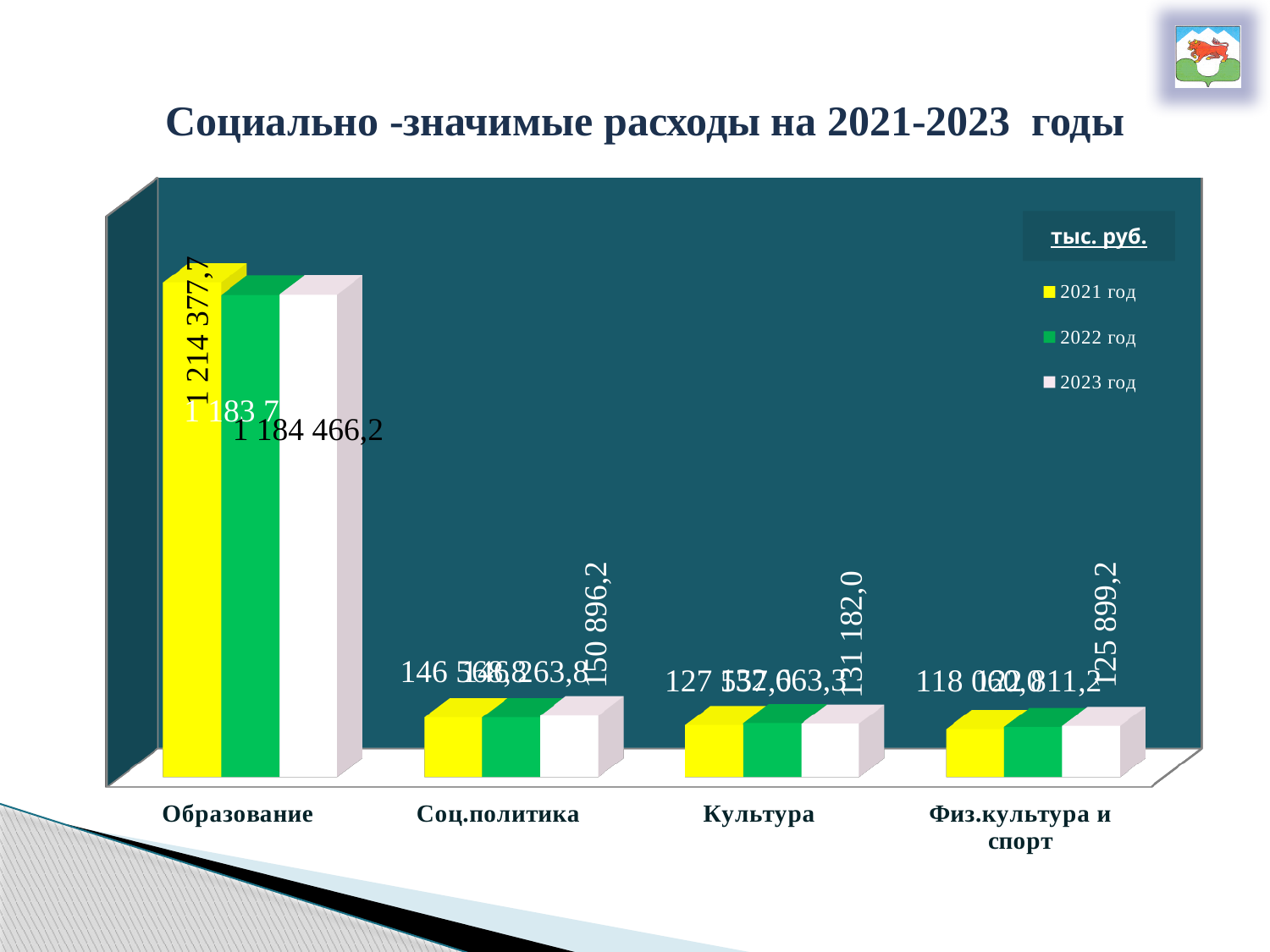
What is the value for Культура in 2023 год? 131 182,0 What is the difference between the 2023 год values for Соц.политика and Культура? 19 714,2 What is the value for Образование in 2023 год? 1 184 466,2 What is the value for Образование in 2021 год? 1 214 377,7 How many categories are shown on the x axis? 4 What is the value for Физ.культура и спорт in 2023 год? 125 899,2 Which category has the highest values across all years? Образование What is the value for Соц.политика in 2023 год? 150 896,2 How many series does the legend list? 3 Which is larger for 2023 год: Соц.политика or Культура? Соц.политика What is the difference between the 2021 год and 2023 год values for Образование? 29 911,5 Which category has the lowest value for 2023 год? Физ.культура и спорт